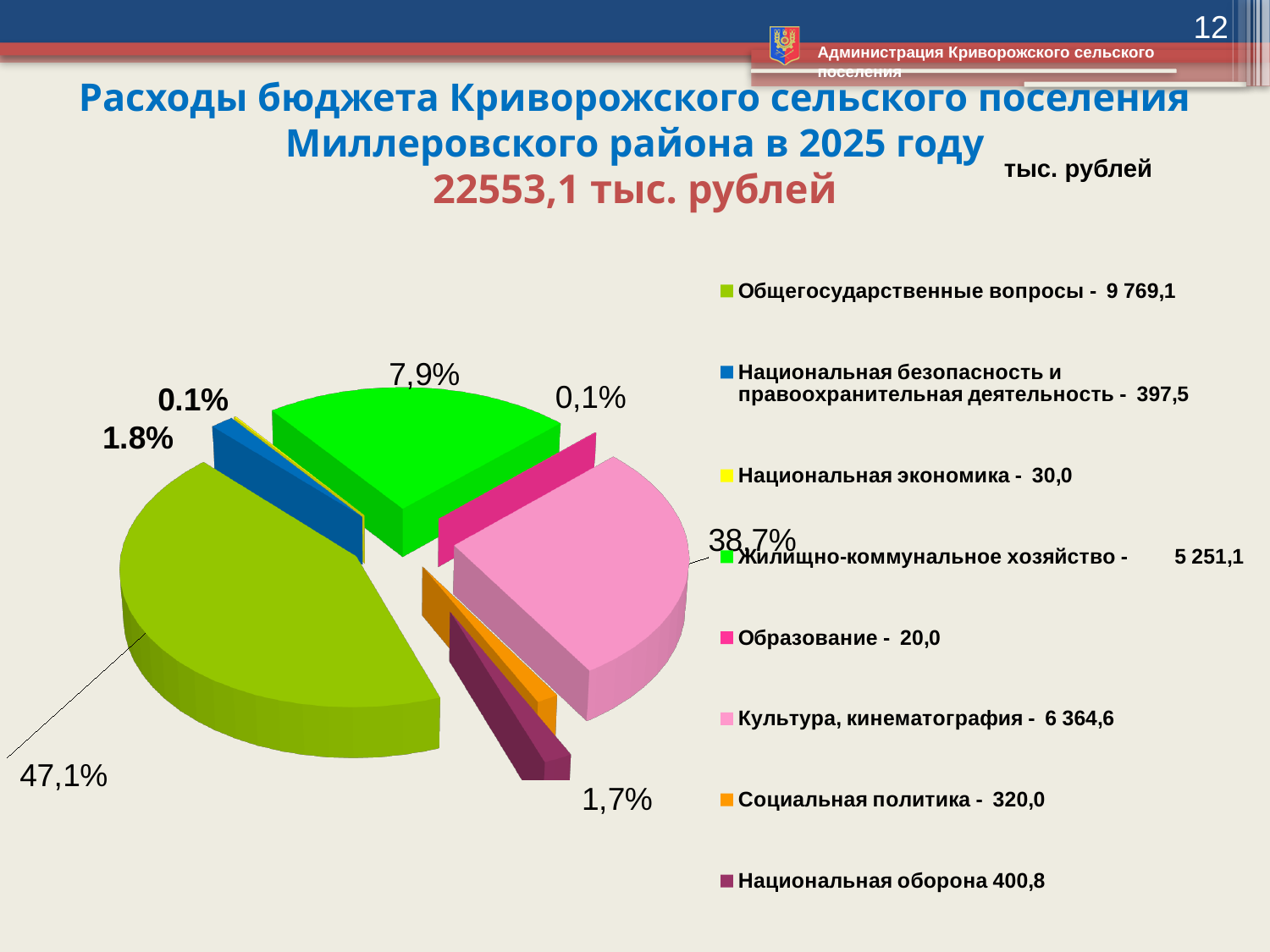
What kind of chart is shown on the slide? pie chart What value is given in the legend for Социальная политика? 320,0 What value is given in the legend for Общегосударственные вопросы? 9 769,1 What is the difference between the values for Культура, кинематография and Жилищно-коммунальное хозяйство? 1 113,5 Which category has the largest value in the legend? Общегосударственные вопросы What total budget expenditure amount is stated in the chart title? 22553,1 тыс. рублей What value is given in the legend for Культура, кинематография? 6 364,6 Which category has the smallest value in the legend? Образование Which has the larger value, Национальная оборона or Национальная безопасность и правоохранительная деятельность? Национальная оборона What percentage share is labelled for the largest slice (Общегосударственные вопросы)? 47,1% How many expenditure categories does the legend of the pie chart list? 8 What value is given in the legend for Национальная экономика? 30,0